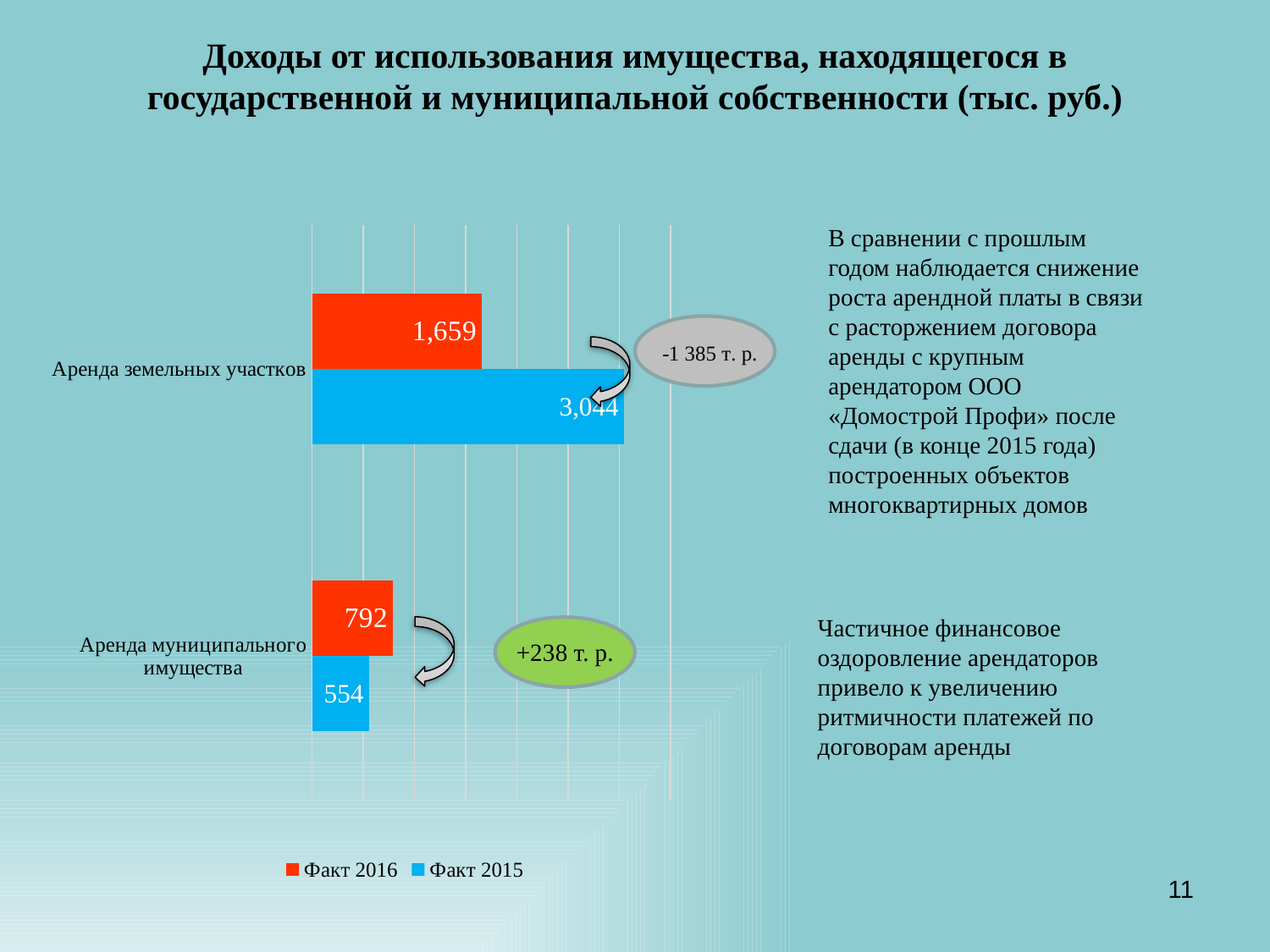
Which category has the lowest Факт 2016 value? Аренда муниципального имущества What kind of chart is shown on the slide? Bar chart For Аренда муниципального имущества, which is larger: Факт 2016 or Факт 2015? Факт 2016 What is the Факт 2016 value for Аренда муниципального имущества? 792 What is the difference between the Факт 2015 and Факт 2016 values for Аренда земельных участков? 1,385 How many categories are shown in the chart? 2 What is the difference between the Факт 2016 and Факт 2015 values for Аренда муниципального имущества? 238 Which category has the highest Факт 2015 value? Аренда земельных участков What is the Факт 2015 value for Аренда муниципального имущества? 554 What is the Факт 2015 value for Аренда земельных участков? 3,044 What is the Факт 2016 value for Аренда земельных участков? 1,659 How many series does the legend list? 2